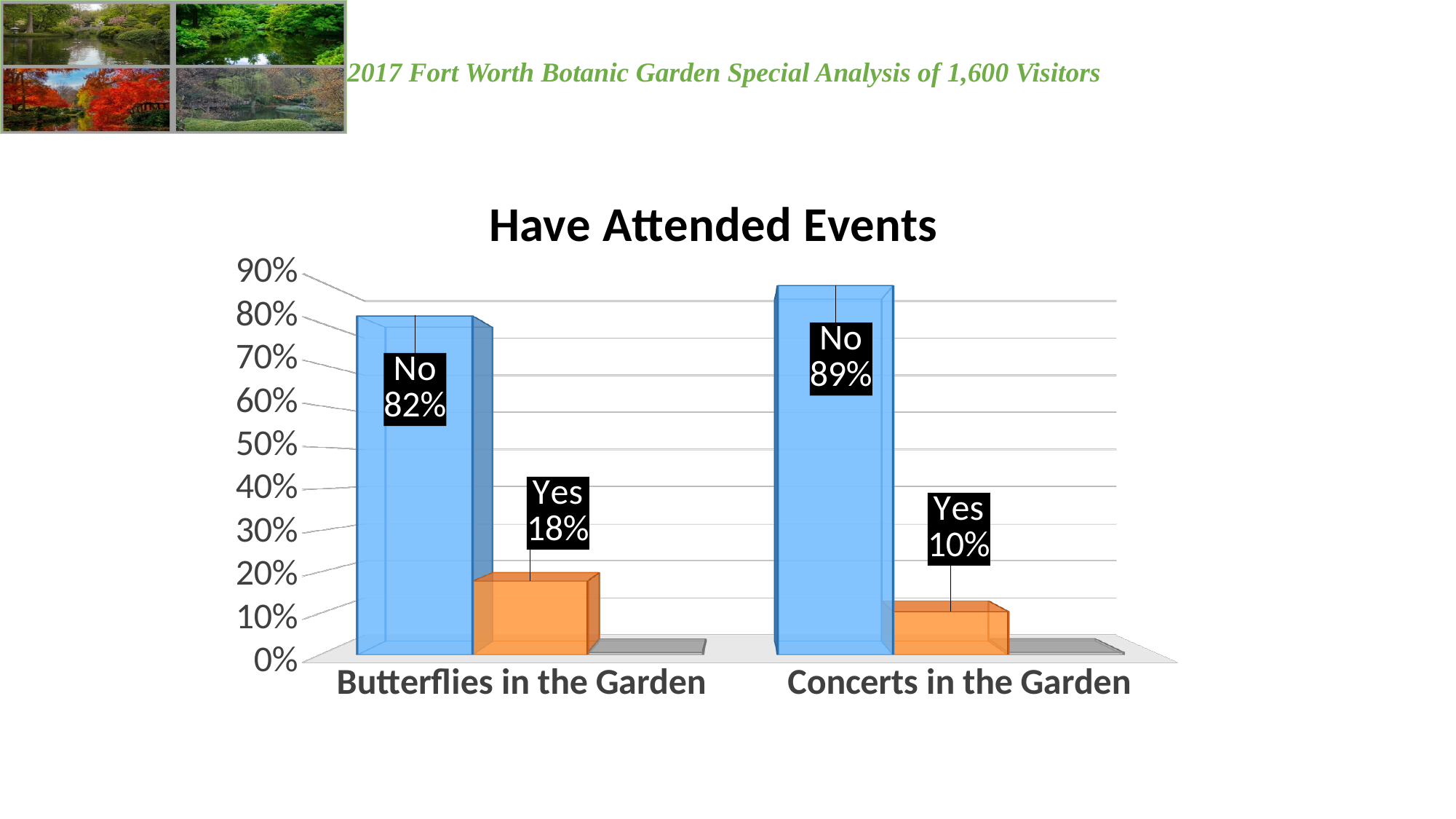
What percentage of visitors answered Yes for Butterflies in the Garden? 18% How many event categories are shown on the x axis? 2 Is the Yes value for Butterflies in the Garden larger or smaller than the Yes value for Concerts in the Garden? larger What is the difference between the Yes percentages for Butterflies in the Garden and Concerts in the Garden? 8% What is the title of the chart? Have Attended Events What is the difference between the No percentages for Concerts in the Garden and Butterflies in the Garden? 7% What kind of chart is shown on the slide? bar chart Which event has the higher Yes percentage? Butterflies in the Garden What percentage of visitors answered No for Concerts in the Garden? 89% What percentage of visitors answered Yes for Concerts in the Garden? 10% Which event has the lower No percentage? Butterflies in the Garden What percentage of visitors answered No for Butterflies in the Garden? 82%